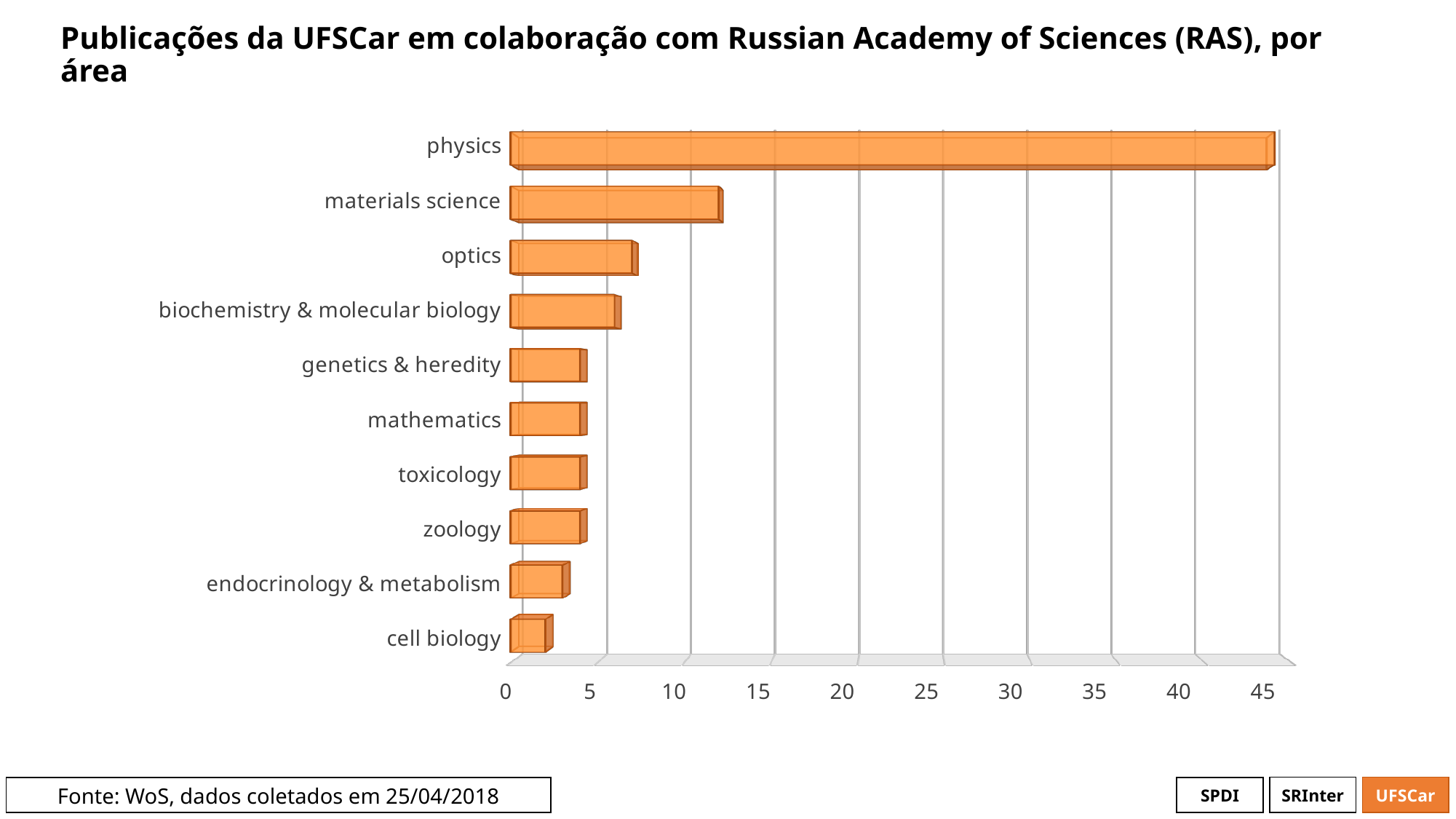
What is the highest value shown on the horizontal axis? 45 Is the value for cell biology greater or less than 5? less Is the value for optics greater or less than 10? less Which has more publications, materials science or optics? materials science Which has more publications, endocrinology & metabolism or cell biology? endocrinology & metabolism Which area has the highest number of publications? physics Is the value for physics greater or less than 40? greater Which area has the lowest number of publications? cell biology How many areas are listed on the chart? 10 What kind of chart is shown on the slide? bar chart